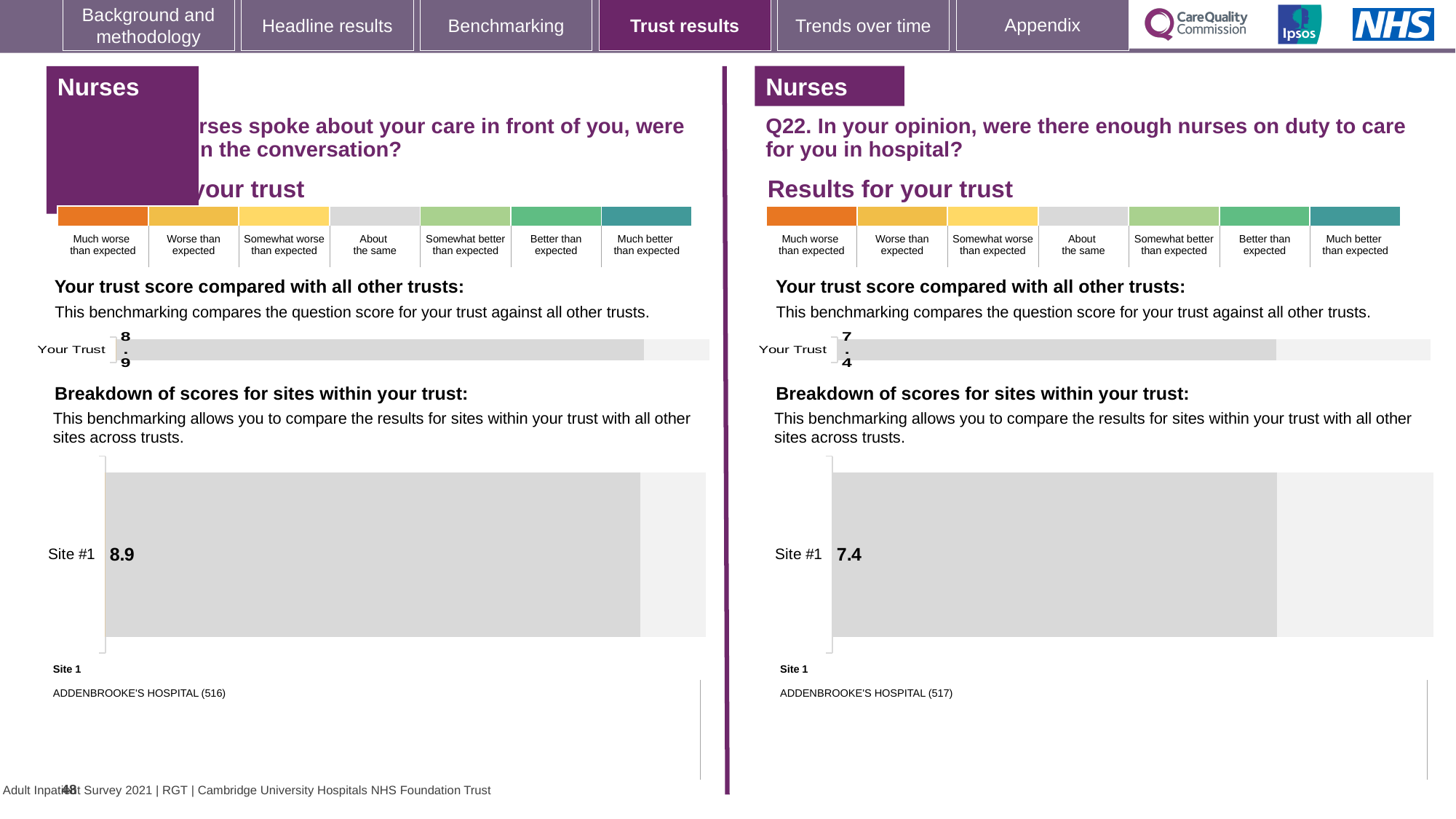
Is the Site #1 score on the right half of the slide (Q22) greater or less than 8? less On the left half of the slide, what is the score shown for Site #1 in the breakdown of scores for sites within your trust? 8.9 Which is larger: the Site #1 score on the left half of the slide or the Site #1 score on the right half (Q22)? Left half (8.9) On the right half of the slide (Q22), what is the score shown for Site #1 in the breakdown of scores for sites within your trust? 7.4 Is the Site #1 score on the left half of the slide greater or less than 8? greater On the right half of the slide (Q22), which site is listed as Site 1 below the breakdown chart? ADDENBROOKE'S HOSPITAL (517) How many sites are shown in the breakdown of scores chart on the right half of the slide (Q22)? 1 What is the difference between the Site #1 score on the left half of the slide (8.9) and the Site #1 score on the right half (7.4)? 1.5 What kind of chart is used to show the Site #1 score on the left half of the slide? Bar chart On the left half of the slide, what value is shown for 'Your Trust' in the trust score comparison chart? 8.9 On the right half of the slide (Q22), what value is shown for 'Your Trust' in the trust score comparison chart? 7.4 On the left half of the slide, which site is listed as Site 1 below the breakdown chart? ADDENBROOKE'S HOSPITAL (516)